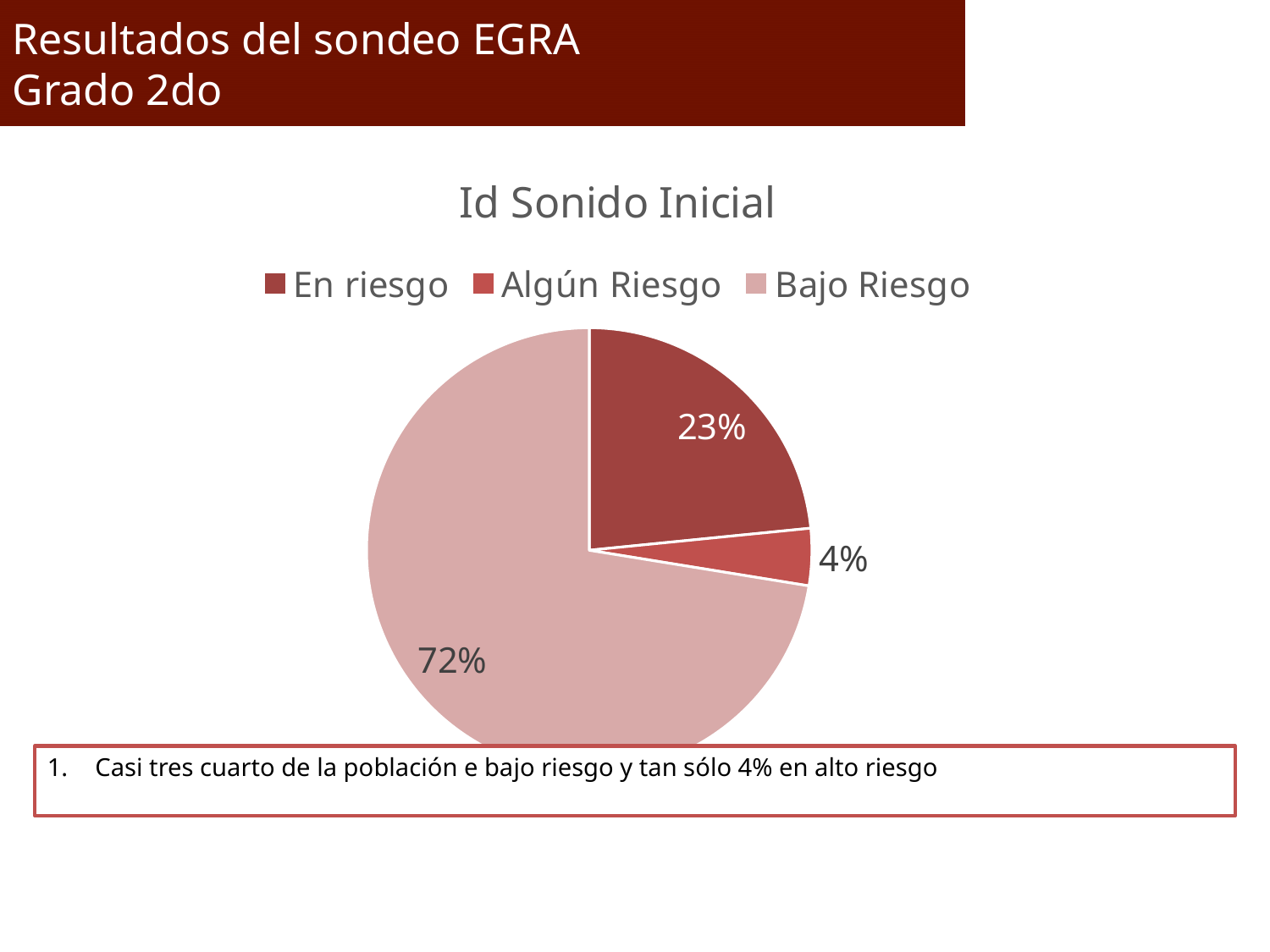
Which category has the smallest share of the pie? Algún Riesgo Which is larger, the share for En riesgo or the share for Algún Riesgo? En riesgo What type of chart is shown on the slide? pie chart What percentage of the pie is labelled for Bajo Riesgo? 72% Which category has the largest share of the pie? Bajo Riesgo How many categories does the legend list? 3 What percentage of the pie is labelled for En riesgo? 23% What is the title of the chart? Id Sonido Inicial What is the difference in percentage points between Bajo Riesgo and En riesgo? 49 Which category is shown in the lightest pink colour? Bajo Riesgo What percentage of the pie is labelled for Algún Riesgo? 4% How many slices does the pie chart have? 3